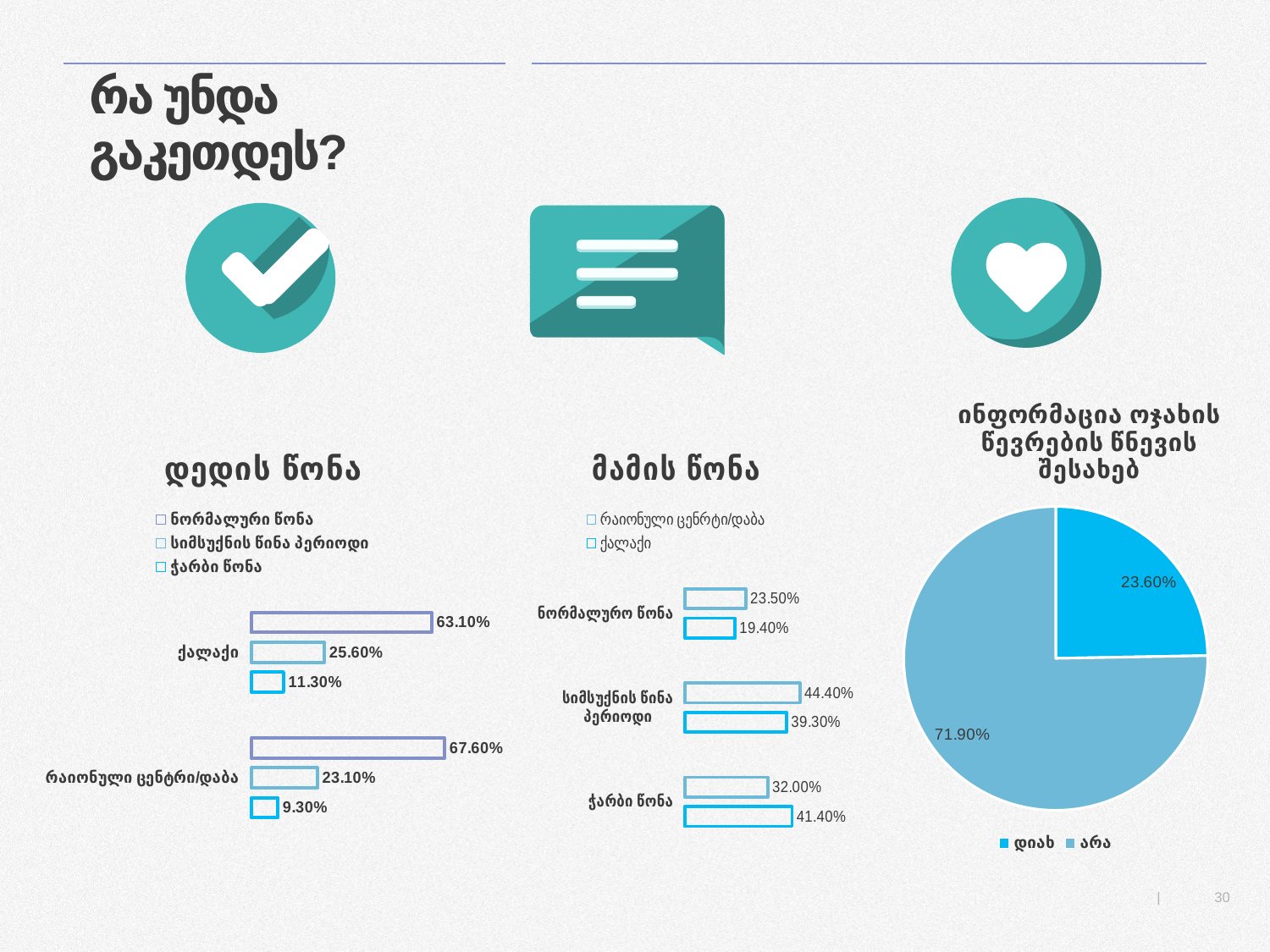
In the chart titled "მამის წონა", what is the difference between the ქალაქი and რაიონული ცენტრი/დაბა values for ჭარბი წონა? 9.40% In the chart titled "მამის წონა", which category has the highest რაიონული ცენტრი/დაბა value? სიმსუქნის წინა პერიოდი In the chart titled "მამის წონა", what is the რაიონული ცენტრი/დაბა value for სიმსუქნის წინა პერიოდი? 44.40% In the chart titled "დედის წონა", how many series does the legend list? 3 In the chart titled "მამის წონა", what is the ქალაქი value for ჭარბი წონა? 41.40% What type of chart is the chart titled "ინფორმაცია ოჯახის წევრების წნევის შესახებ"? pie chart In the pie chart titled "ინფორმაცია ოჯახის წევრების წნევის შესახებ", what share does არა have? 71.90% In the chart titled "დედის წონა", what is the value of the ჭარბი წონა series for რაიონული ცენტრი/დაბა? 9.30% In the chart titled "დედის წონა", what is the value of the ნორმალური წონა series for ქალაქი? 63.10% In the chart titled "მამის წონა", how many categories are shown? 3 In the chart titled "დედის წონა", what is the difference between the ნორმალური წონა values for რაიონული ცენტრი/დაბა and ქალაქი? 4.50% In the chart titled "დედის წონა", which category has the higher სიმსუქნის წინა პერიოდი value, ქალაქი or რაიონული ცენტრი/დაბა? ქალაქი